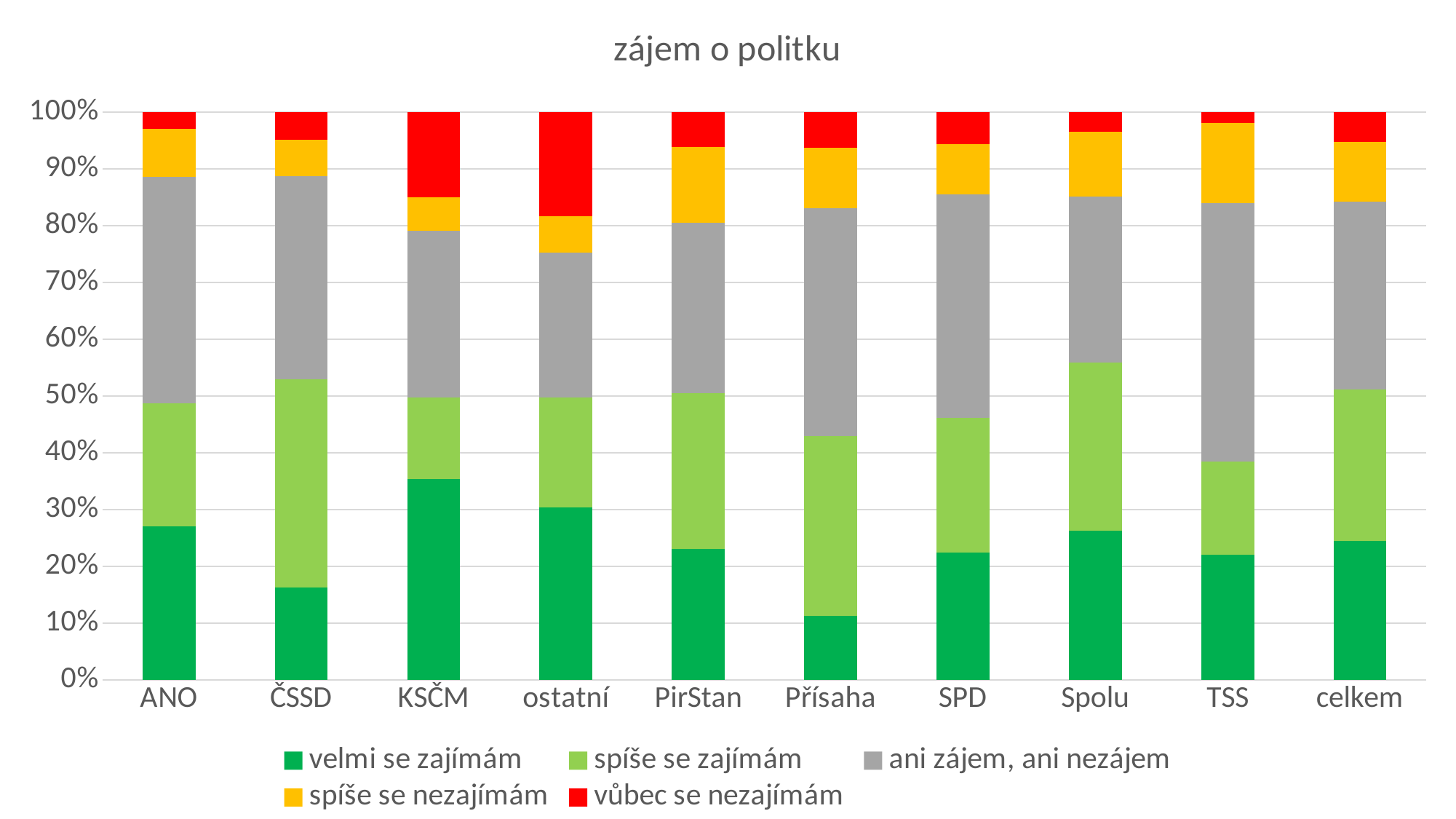
Which category has the smallest 'velmi se zajímám' segment? Přísaha Which category has the largest 'velmi se zajímám' segment? KSČM How many categories are shown on the x axis? 10 What kind of chart is shown on the slide? stacked bar chart Which category has the smallest 'vůbec se nezajímám' segment? TSS Is the 'velmi se zajímám' value for Přísaha greater or less than 20%? less Is the 'velmi se zajímám' value for KSČM greater or less than 30%? greater What is the title of the chart? zájem o politku What is the total height of each stacked bar? 100% Which has a larger 'velmi se zajímám' segment, KSČM or ČSSD? KSČM How many series does the legend list? 5 Which category has the largest 'ani zájem, ani nezájem' segment? TSS